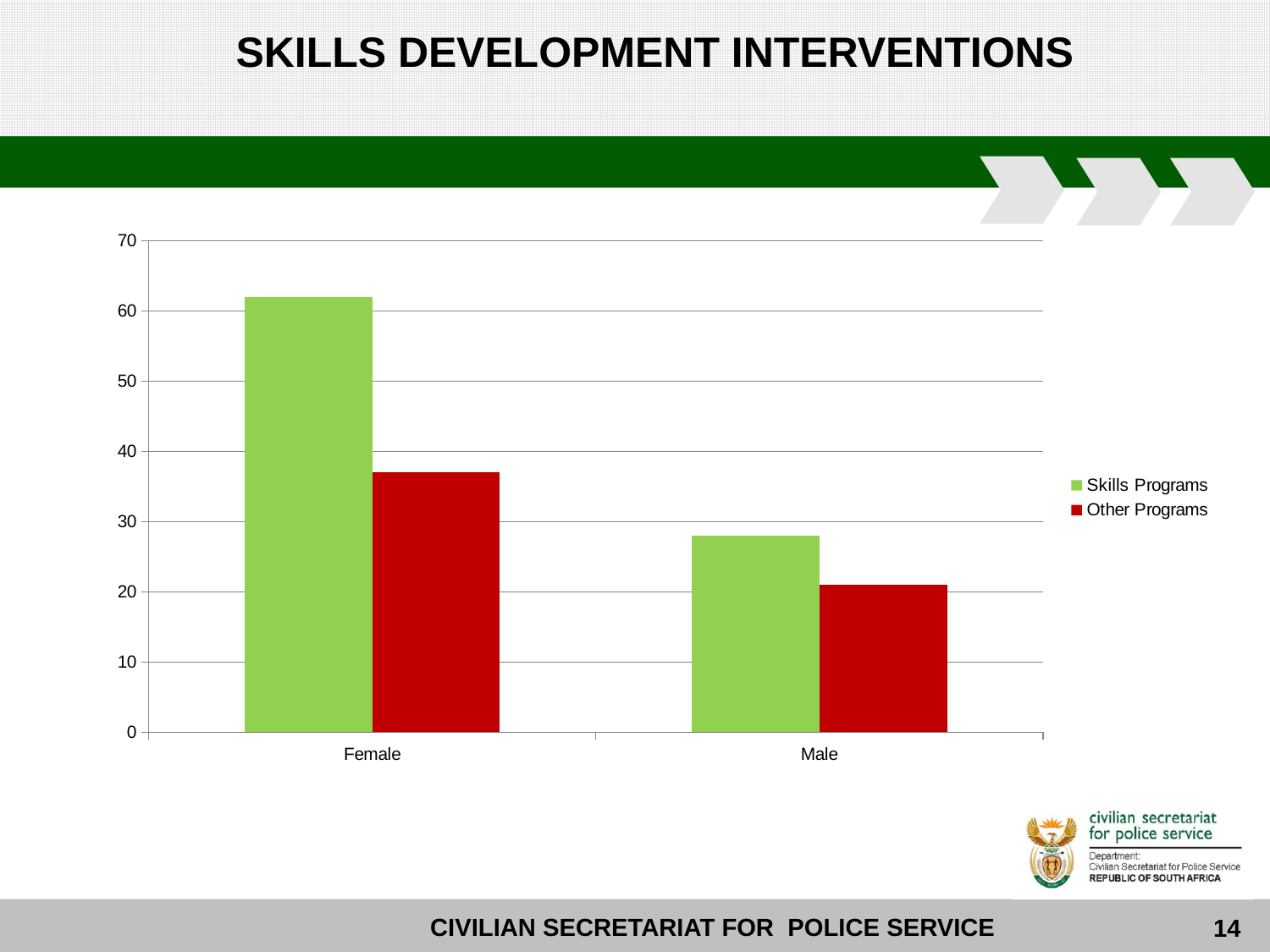
How many series does the legend list? 2 Which category has the lowest Other Programs bar? Male Is the Skills Programs value for Female greater or less than 60? greater Which category has the highest Skills Programs bar? Female How many categories are shown on the x axis? 2 What colour represents Other Programs in the legend? red Which is larger for Male: Skills Programs or Other Programs? Skills Programs What kind of chart is shown on the slide? bar chart Is the Skills Programs value for Male greater or less than 30? less Which is larger: Other Programs for Female or Skills Programs for Male? Other Programs for Female Is the Other Programs value for Female greater or less than 40? less